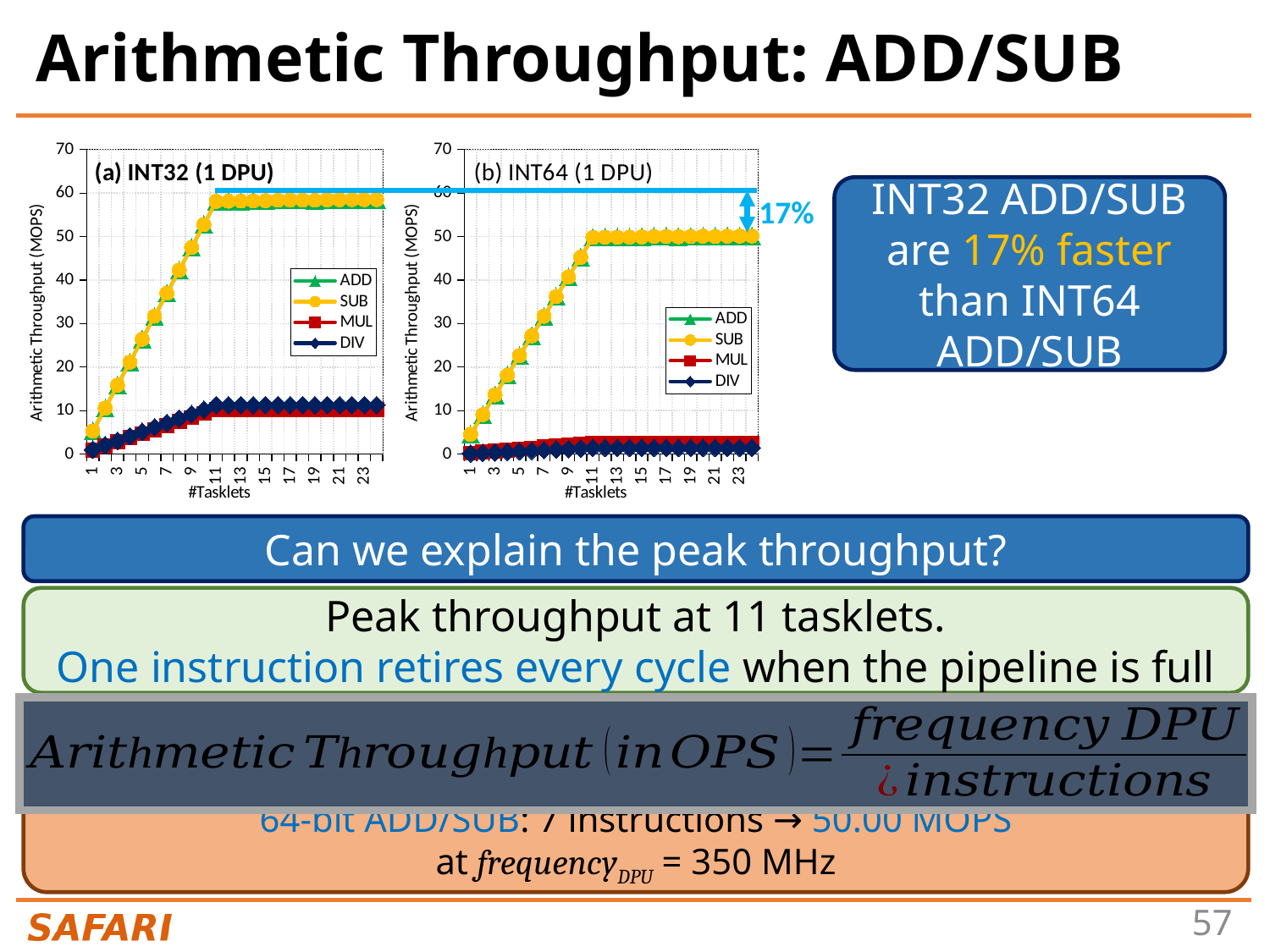
In the (a) INT32 (1 DPU) chart, which is larger at 24 tasklets: the DIV throughput or the MUL throughput? DIV What is the label of the y axis on the (a) INT32 (1 DPU) chart? Arithmetic Throughput (MOPS) In the (a) INT32 (1 DPU) chart, which series has the lowest throughput at 24 tasklets? MUL In the (b) INT64 (1 DPU) chart, is the DIV throughput at 24 tasklets greater or less than 10 MOPS? less In the (b) INT64 (1 DPU) chart, is the SUB throughput at 24 tasklets greater or less than 60 MOPS? less What is the label of the x axis on the (b) INT64 (1 DPU) chart? #Tasklets Which is larger at 24 tasklets: ADD throughput in the (a) INT32 (1 DPU) chart or ADD throughput in the (b) INT64 (1 DPU) chart? (a) INT32 (1 DPU) What kind of chart is the (a) INT32 (1 DPU) chart? line chart How many series does the legend of the (b) INT64 (1 DPU) chart list? 4 In the (a) INT32 (1 DPU) chart, is the ADD throughput at 24 tasklets greater or less than 50 MOPS? greater In the (b) INT64 (1 DPU) chart, how does the ADD throughput change as the number of tasklets increases from 1 to 11? It rises